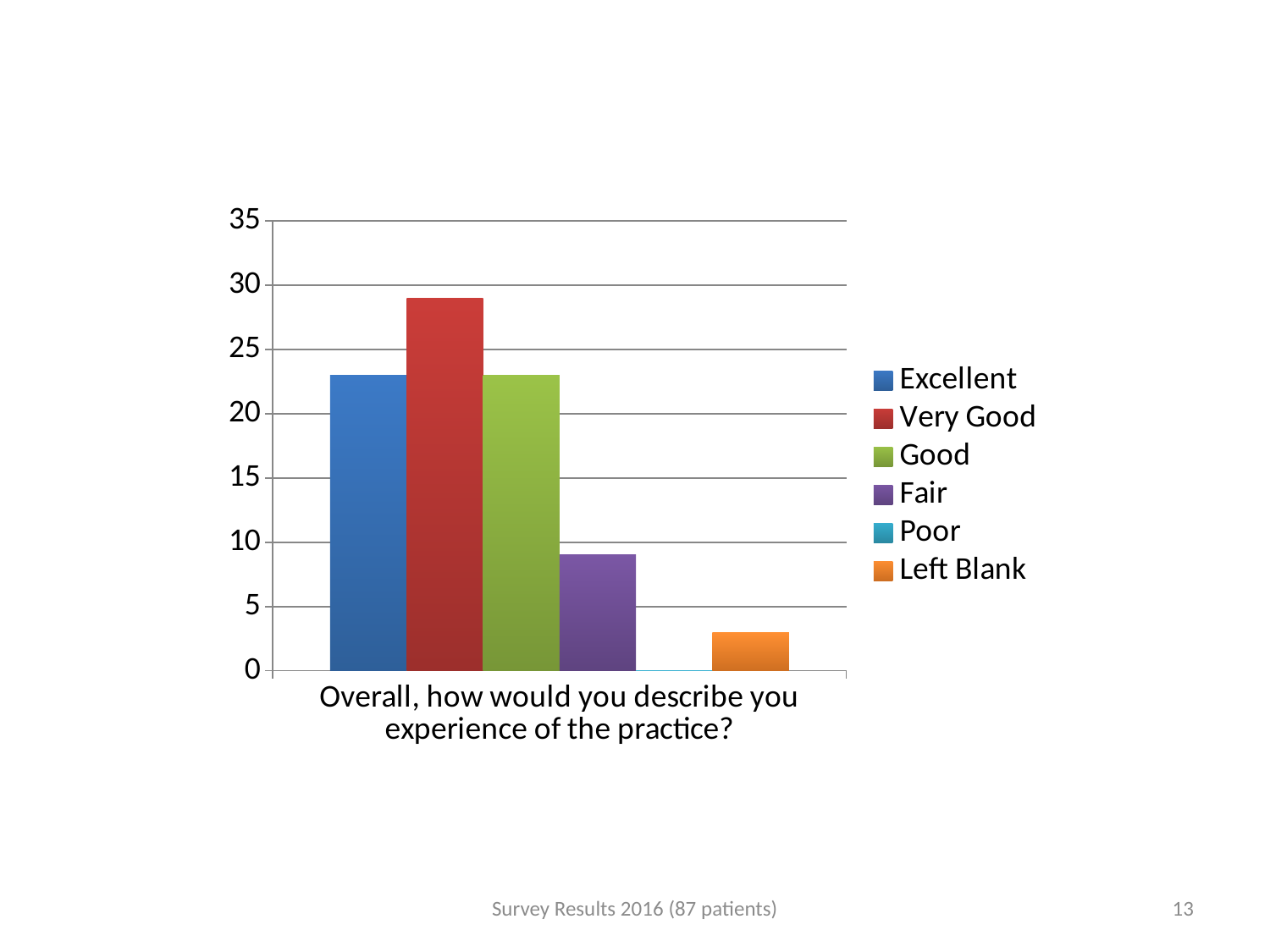
What kind of chart is shown on the slide? bar chart How many series does the legend list? 6 Is the value for Fair greater or less than 10? less Is the value for Excellent greater or less than 20? greater Which is larger, the value for Fair or the value for Left Blank? Fair Which is larger, the value for Very Good or the value for Excellent? Very Good Which response has the highest bar? Very Good Is the value for Left Blank greater or less than 5? less What question is shown as the category label below the bars? Overall, how would you describe you experience of the practice? Which response has the lowest bar? Poor